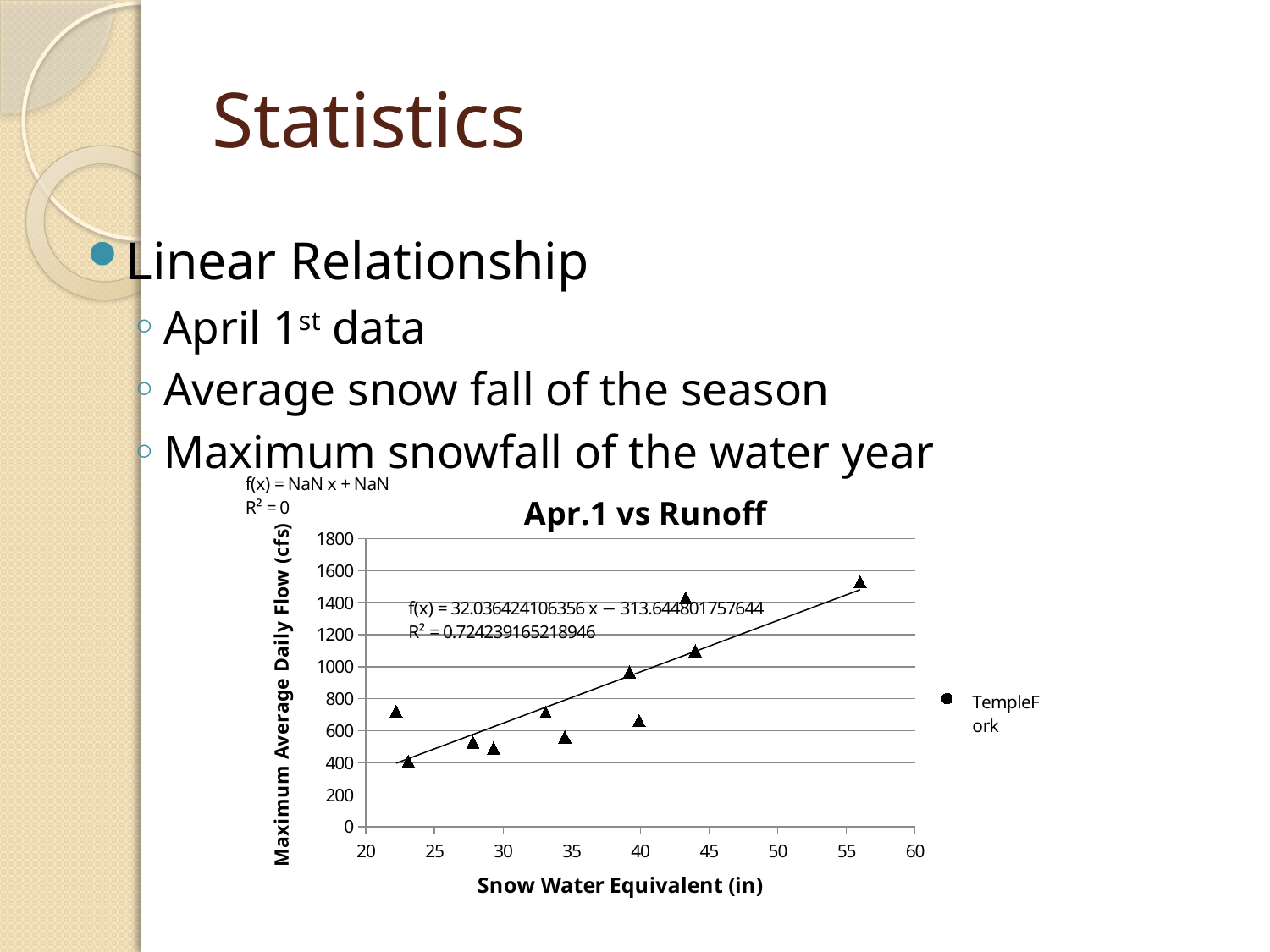
What kind of chart is shown on the slide? scatter chart How many series does the chart legend list? 1 What is the highest value shown on the y axis? 1800 What is the title of the chart? Apr.1 vs Runoff Do the plotted values generally rise or fall as Snow Water Equivalent increases? rise What is the name of the series shown in the legend? TempleFork What is the slope of the trendline equation printed on the chart? 32.036424106356 What is the R² value printed on the chart for the fitted trendline? 0.724239165218946 Is the Maximum Average Daily Flow for the point with the highest Snow Water Equivalent (near 56 in) greater or less than 1400? greater Which has the higher Maximum Average Daily Flow: the point near 56 in or the point near 44 in of Snow Water Equivalent? the point near 56 in